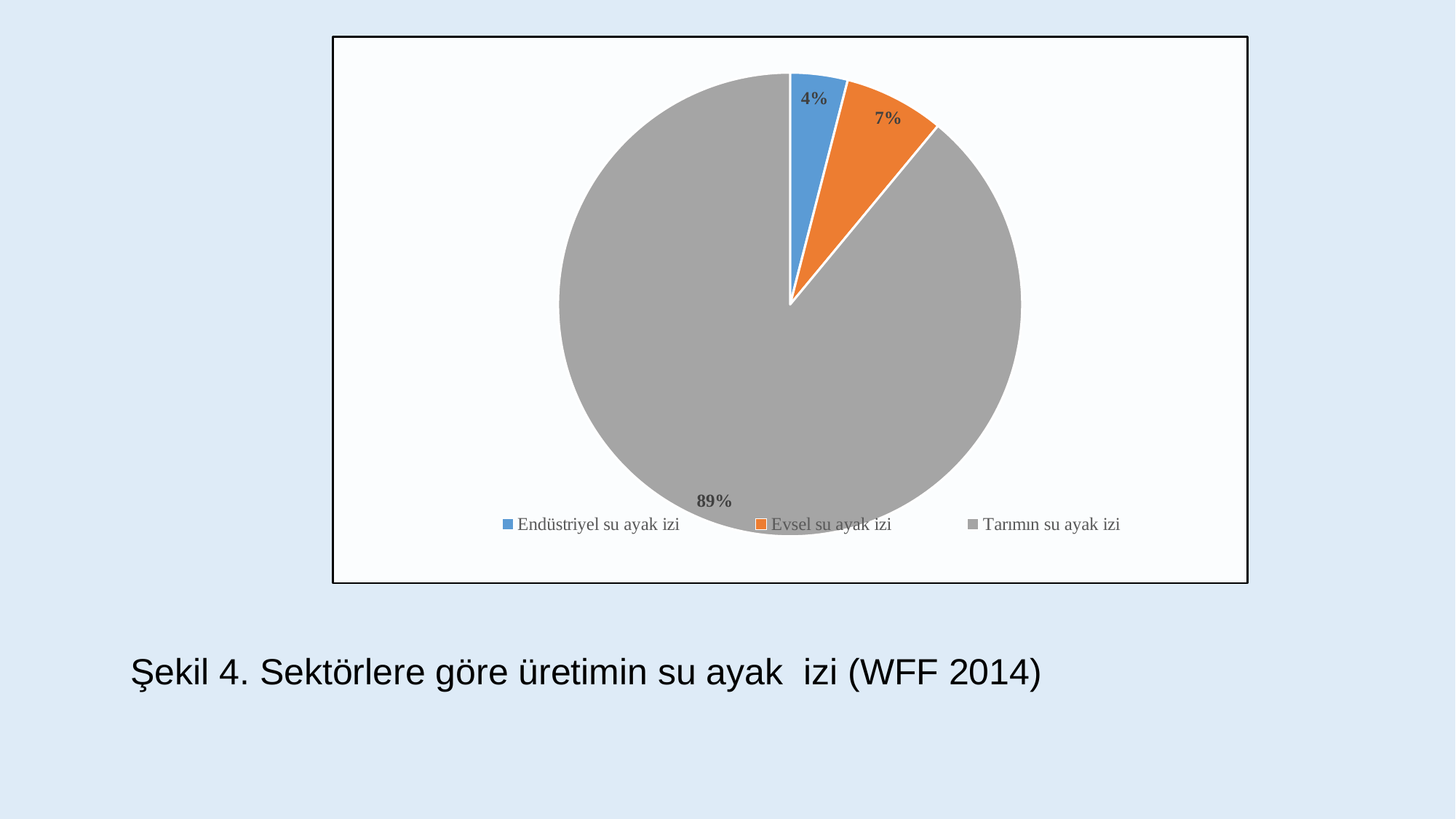
What share of the pie does Evsel su ayak izi have? 7% What is the difference in percentage points between Evsel su ayak izi and Endüstriyel su ayak izi? 3 Which category has the largest slice of the pie? Tarımın su ayak izi What colour is the slice for Tarımın su ayak izi? grey Which category has the smallest slice of the pie? Endüstriyel su ayak izi What is the difference in percentage points between Tarımın su ayak izi and Evsel su ayak izi? 82 What is the caption given for the chart below it? Şekil 4. Sektörlere göre üretimin su ayak izi (WFF 2014) How many slices does the pie chart have? 3 Which is larger, the slice for Evsel su ayak izi or the slice for Endüstriyel su ayak izi? Evsel su ayak izi What share of the pie does Tarımın su ayak izi have? 89% What share of the pie does Endüstriyel su ayak izi have? 4% What kind of chart is shown on the slide? pie chart